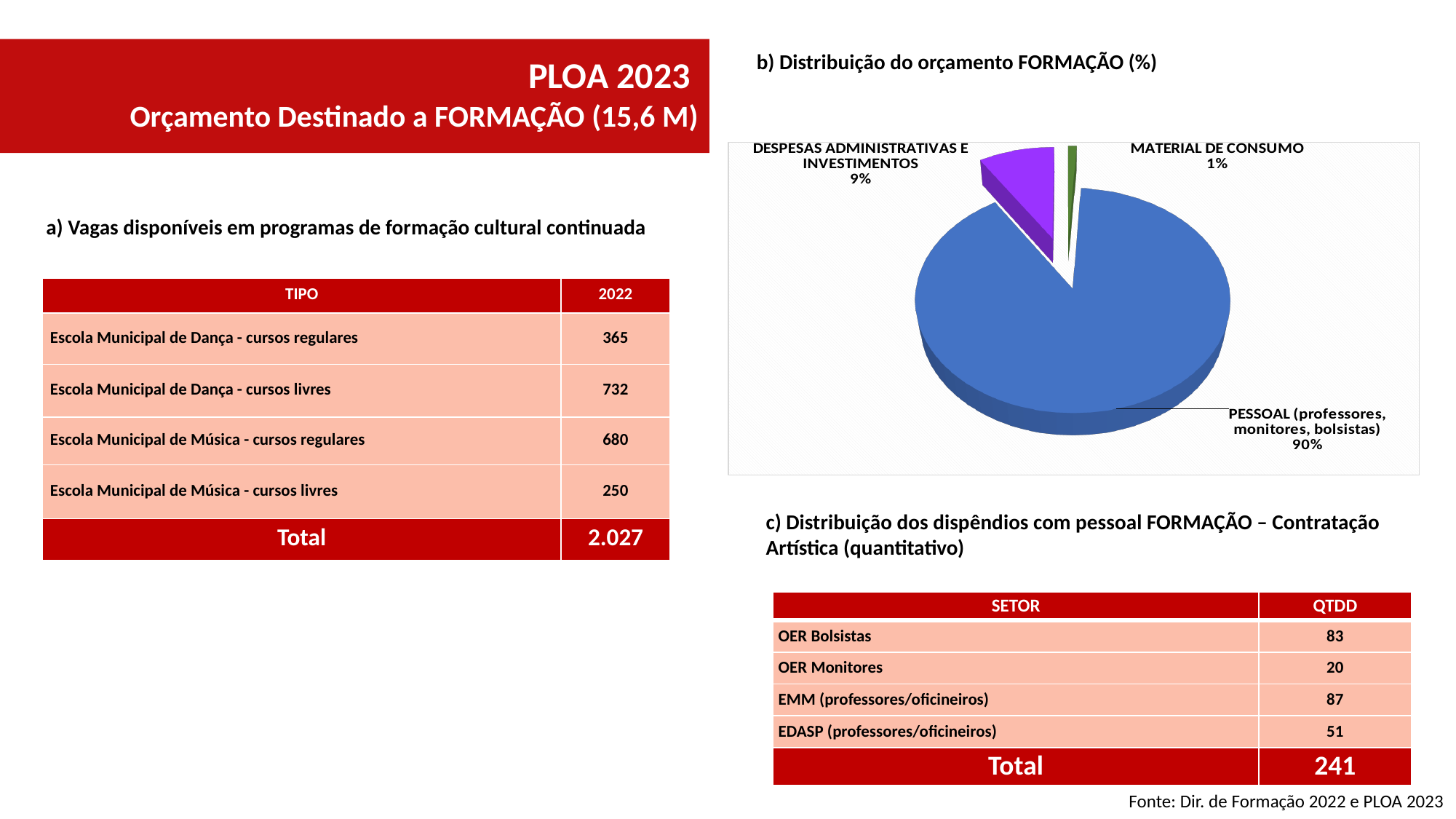
In the pie chart, what share of the budget goes to PESSOAL (professores, monitores, bolsistas)? 90% In the pie chart, which is larger: DESPESAS ADMINISTRATIVAS E INVESTIMENTOS or MATERIAL DE CONSUMO? DESPESAS ADMINISTRATIVAS E INVESTIMENTOS How many slices does the pie chart have? 3 In the pie chart, what is the combined share of DESPESAS ADMINISTRATIVAS E INVESTIMENTOS and MATERIAL DE CONSUMO? 10% In the pie chart, what share of the budget goes to MATERIAL DE CONSUMO? 1% What colour is the PESSOAL slice in the pie chart? Blue Which slice of the pie chart is the largest? PESSOAL (professores, monitores, bolsistas) What kind of chart is shown under "b) Distribuição do orçamento FORMAÇÃO (%)"? Pie chart Which slice of the pie chart is the smallest? MATERIAL DE CONSUMO What colour is the DESPESAS ADMINISTRATIVAS E INVESTIMENTOS slice in the pie chart? Purple In the pie chart, what share of the budget goes to DESPESAS ADMINISTRATIVAS E INVESTIMENTOS? 9% In the pie chart, what is the difference in percentage points between PESSOAL and DESPESAS ADMINISTRATIVAS E INVESTIMENTOS? 81 percentage points